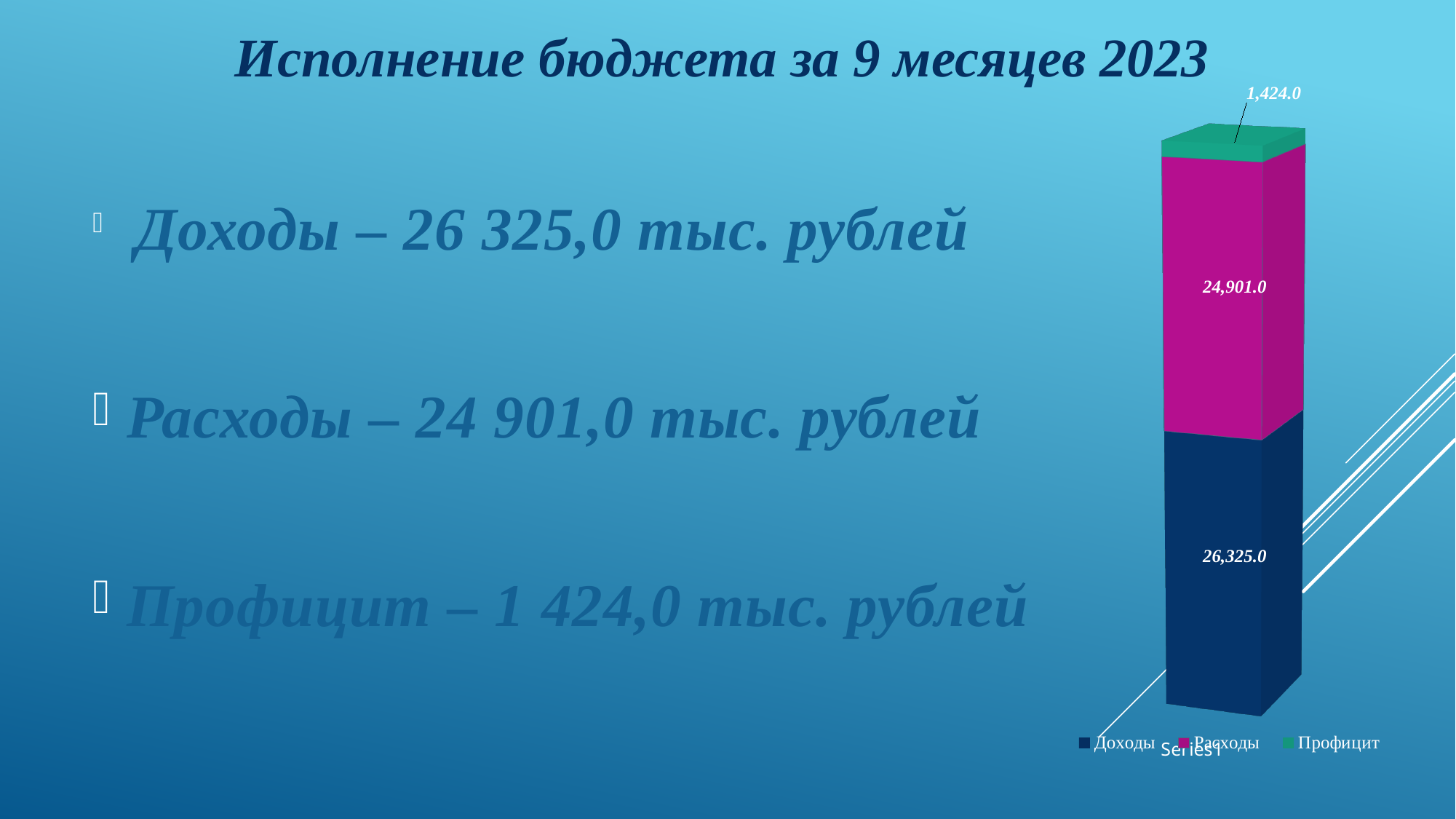
Which is larger in the chart, Расходы or Профицит? Расходы Which series has the smallest value in the chart? Профицит What value is shown for Расходы in the chart? 24,901.0 What value is shown for Доходы in the chart? 26,325.0 What is the difference between the Расходы and Профицит values in the chart? 23,477.0 What colour is the Профицит segment in the chart? Green What kind of chart is shown on the slide? Stacked bar chart What is the total of the stacked bar in the chart? 52,650.0 What is the difference between the Доходы and Расходы values in the chart? 1,424.0 Which series has the largest value in the chart? Доходы What value is shown for Профицит in the chart? 1,424.0 How many series does the chart legend list? 3